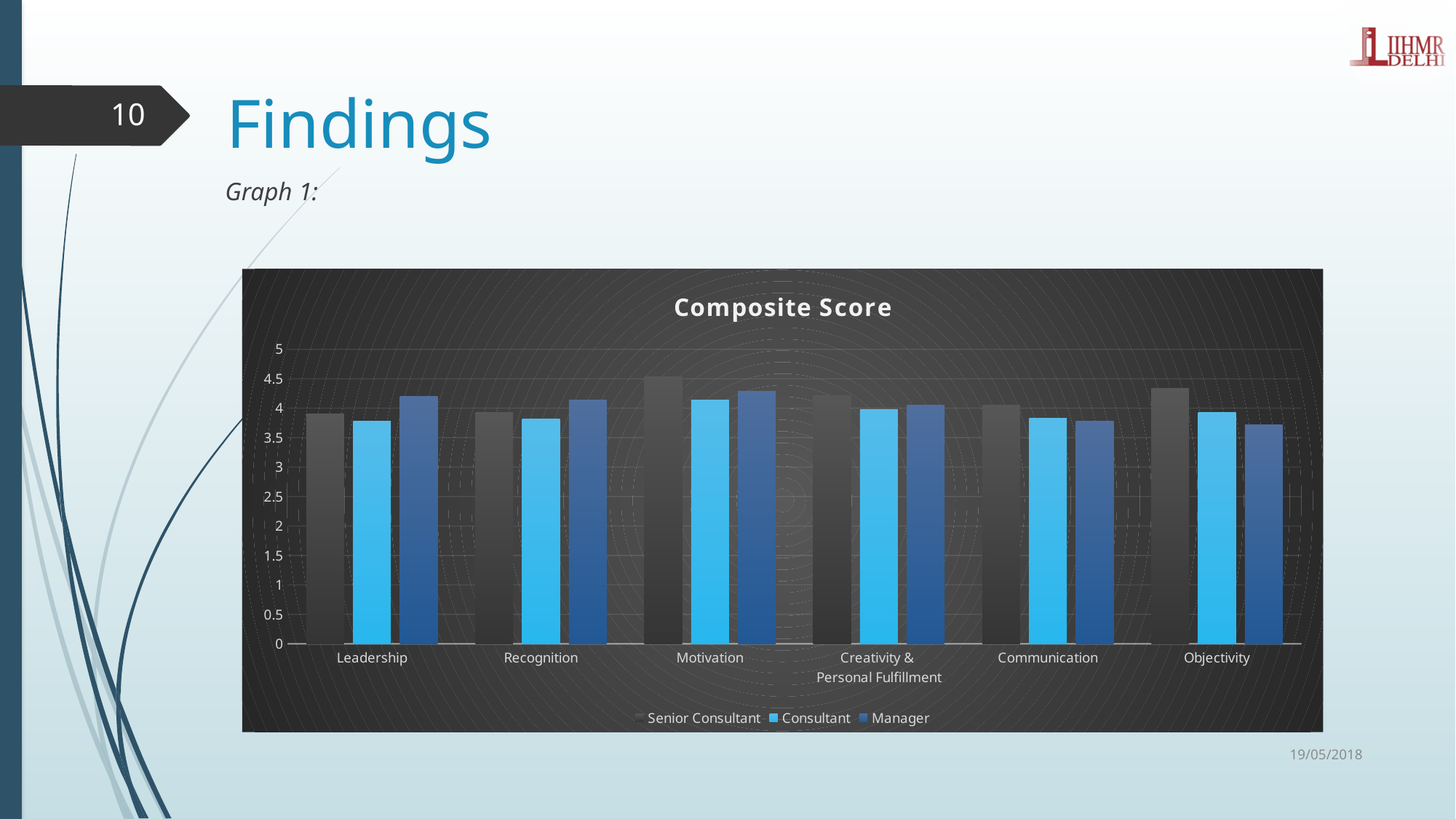
For the Senior Consultant series, which category has the highest value? Motivation Is the Consultant value for Leadership greater or less than 4? less For Leadership, which is larger: the Manager value or the Consultant value? Manager What is the title of the chart? Composite Score What kind of chart is shown on the slide? bar chart How many categories are shown on the x axis of the chart? 6 Is the Senior Consultant value for Motivation greater or less than 4? greater Is the Manager value for Leadership greater or less than 4? greater How many series does the chart's legend list? 3 Which series is shown in light blue in the chart? Consultant For Motivation, which is larger: the Senior Consultant value or the Consultant value? Senior Consultant